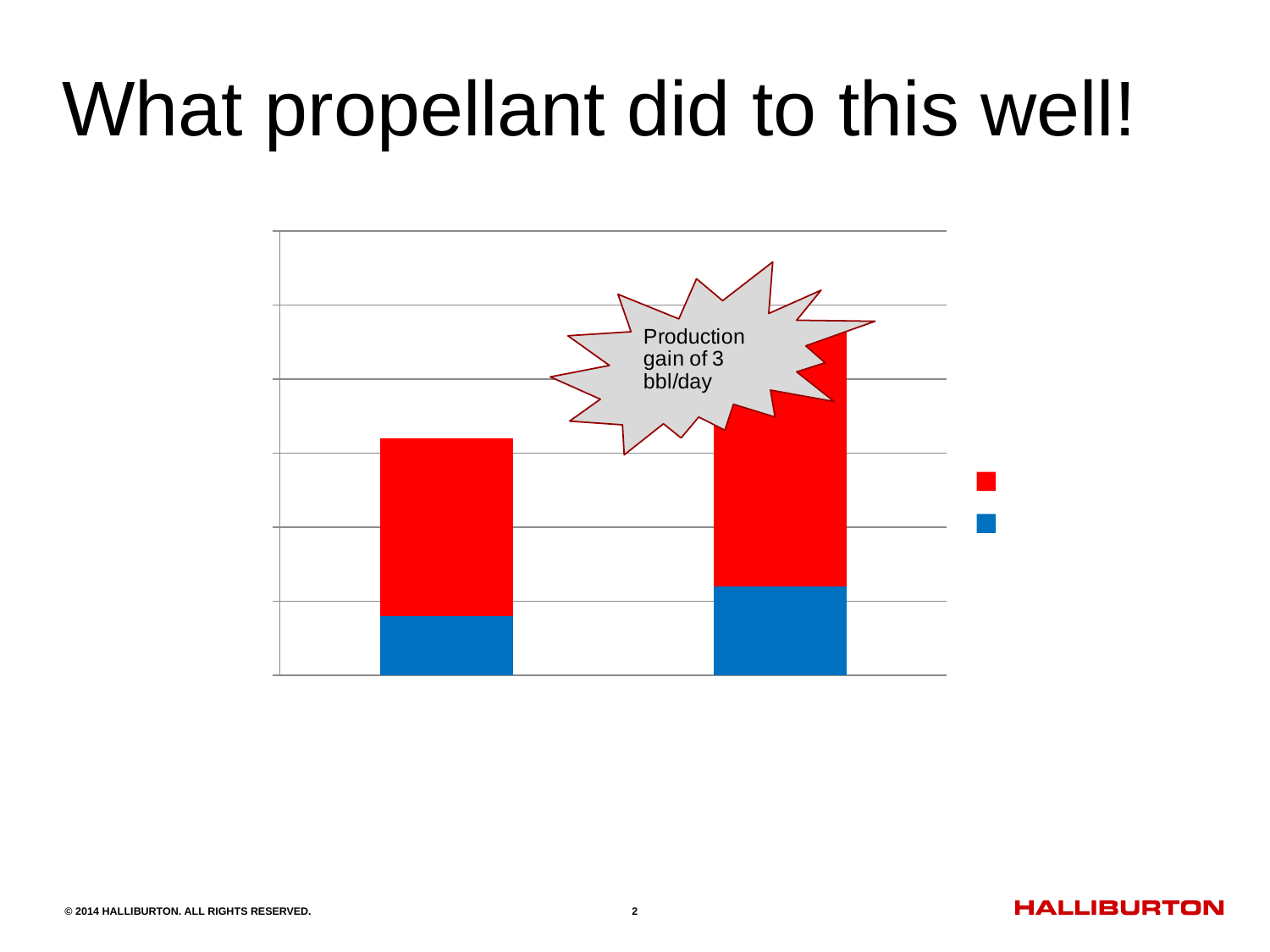
What kind of chart is shown on the slide? stacked bar chart Which bar has the taller red segment, the left bar or the right bar? the right bar Do the bar totals rise or fall from left to right? rise How many bars are plotted in the chart? 2 Which bar has the smallest total height? the left bar Which bar has the greatest total height? the right bar How many series does the chart's legend list? 2 Which bar has the taller blue segment, the left bar or the right bar? the right bar What production gain does the callout on the chart state? 3 bbl/day What two colours are used for the series in the chart? red and blue Which bar is taller, the left bar or the right bar? the right bar